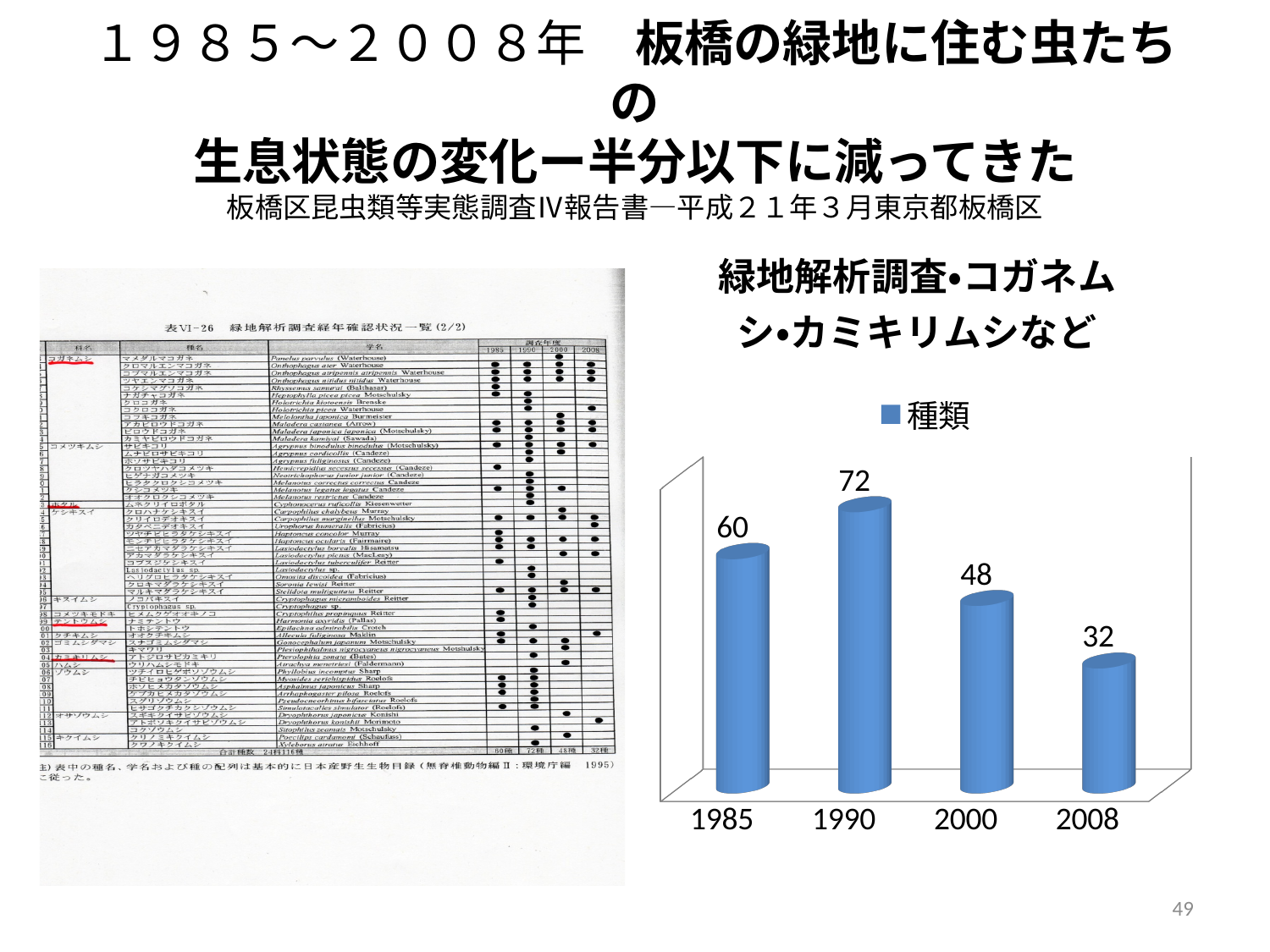
Which year has the highest value? 1990 What is the difference between the values for 1990 and 2008? 40 What is the value for 1990? 72 Which year has the lowest value? 2008 What is the value for 1985? 60 Which is larger, the value for 1985 or the value for 2000? 1985 What kind of chart is shown? bar chart How many years are shown on the x axis? 4 How many series does the legend list? 1 What is the value for 2000? 48 What is the value for 2008? 32 What is the legend entry for the series? 種類